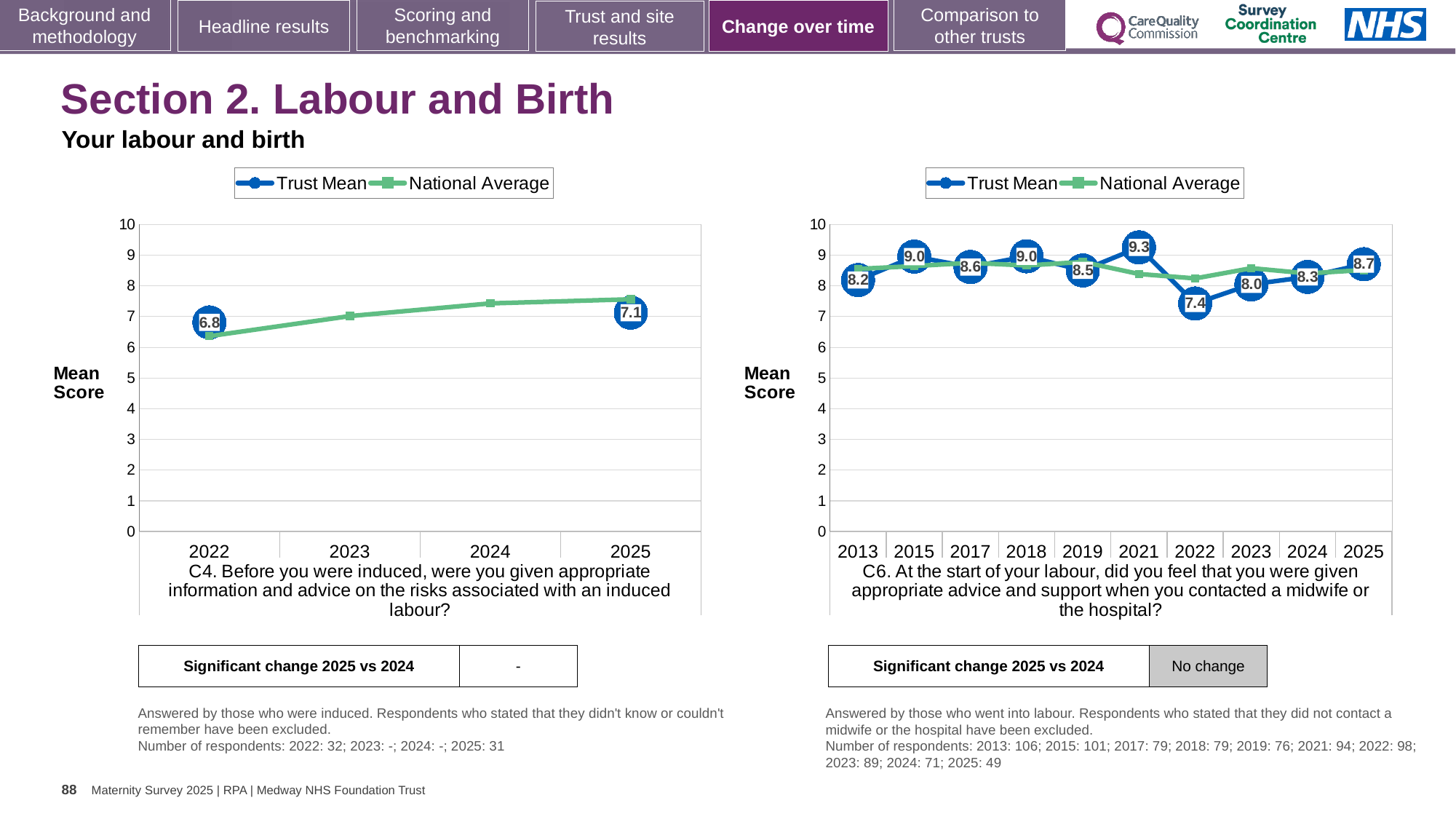
In the left chart (C4), what is the Trust Mean for 2025? 7.1 What kind of chart is the left chart (C4)? line chart In the left chart (C4), by how much did the Trust Mean change from 2022 to 2025? 0.3 In the left chart (C4), what is the Trust Mean for 2022? 6.8 In the right chart (C6), which year has the lowest Trust Mean? 2022 How many years are shown on the x axis of the left chart (C4)? 4 How many years are shown on the x axis of the right chart (C6)? 10 In the right chart (C6), what is the Trust Mean for 2021? 9.3 In the right chart (C6), what is the difference between the Trust Mean for 2025 and 2024? 0.4 How many series does the legend of the left chart (C4) list? 2 In the right chart (C6), which year has the highest Trust Mean? 2021 In the left chart (C4), is the National Average for 2022 greater or less than 7? less